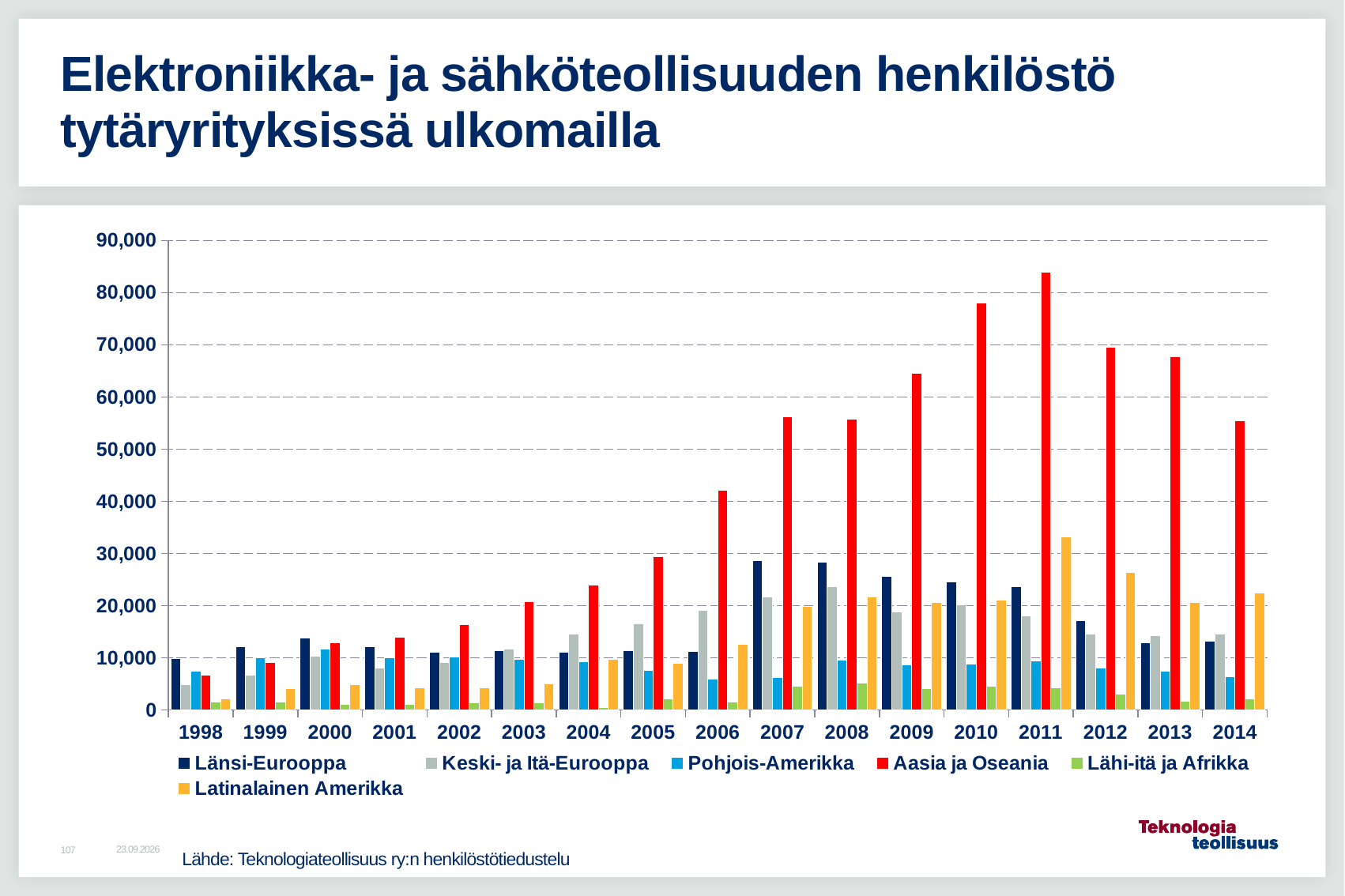
How many series does the legend list? 6 Is the value for Latinalainen Amerikka in 2011 greater or less than 30,000? greater In 2014, which is larger: Aasia ja Oseania or Länsi-Eurooppa? Aasia ja Oseania Is the value for Aasia ja Oseania in 2010 greater or less than 70,000? greater In which year is the value for Aasia ja Oseania highest? 2011 Does the value for Aasia ja Oseania rise or fall from 1998 to 2011? rise What colour represents Aasia ja Oseania in the chart? red How many years are shown on the x axis? 17 Is the value for Aasia ja Oseania in 2011 greater or less than 80,000? greater In 1998, which is larger: Länsi-Eurooppa or Aasia ja Oseania? Länsi-Eurooppa What kind of chart is shown on the slide? bar chart